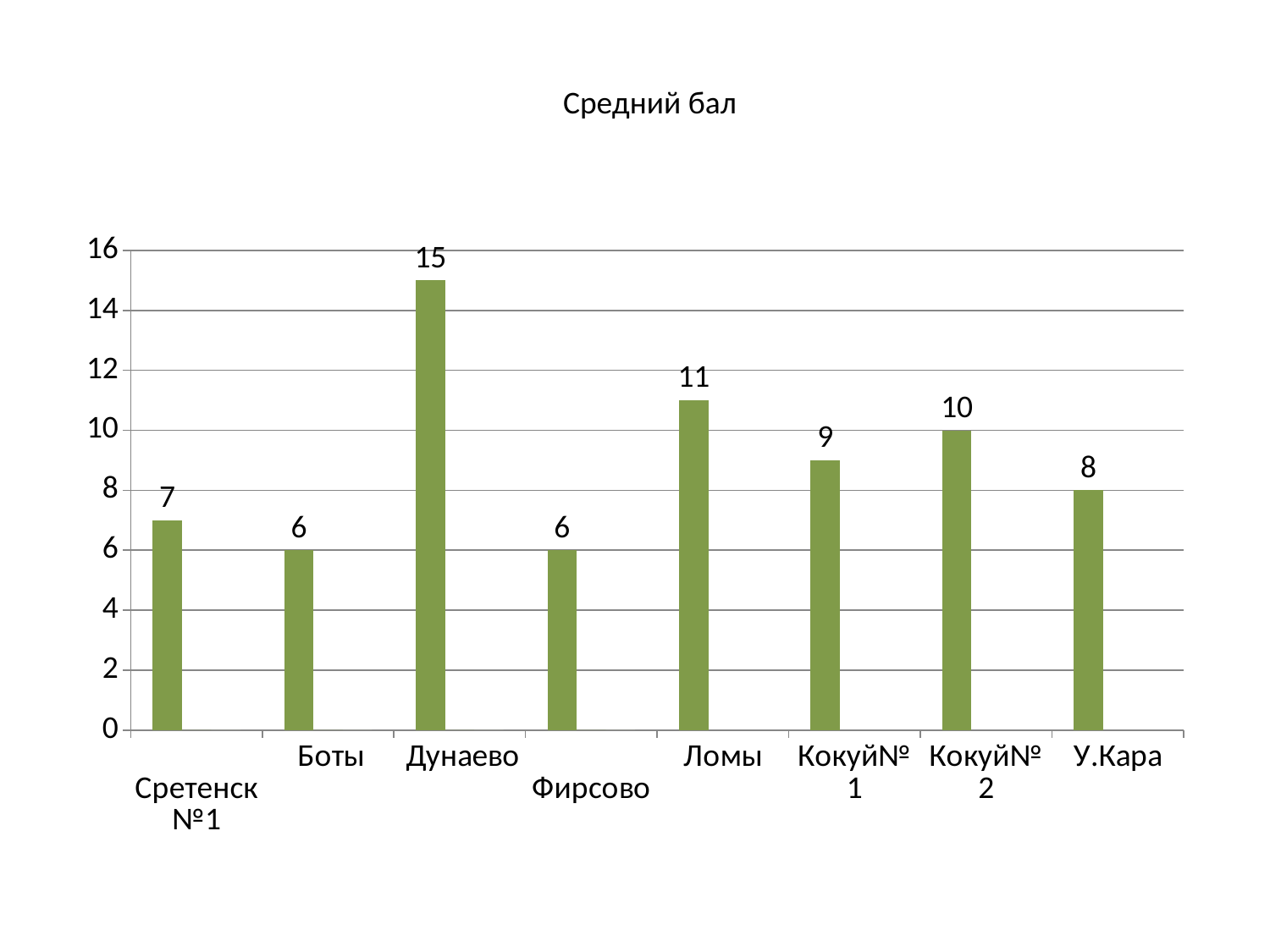
How many categories are shown on the chart? 8 What is the difference between the values for Кокуй№2 and Боты? 4 What is the value for Сретенск №1? 7 What is the value for Дунаево? 15 What kind of chart is shown on the slide? bar chart Which categories share the lowest value on the chart? Боты and Фирсово Which is larger, the value for Кокуй№1 or the value for У.Кара? Кокуй№1 Which category has the highest value? Дунаево Is the value for Ломы greater or less than 10? greater What is the title of the chart? Средний бал What is the value for Кокуй№2? 10 What is the difference between the values for Дунаево and Ломы? 4